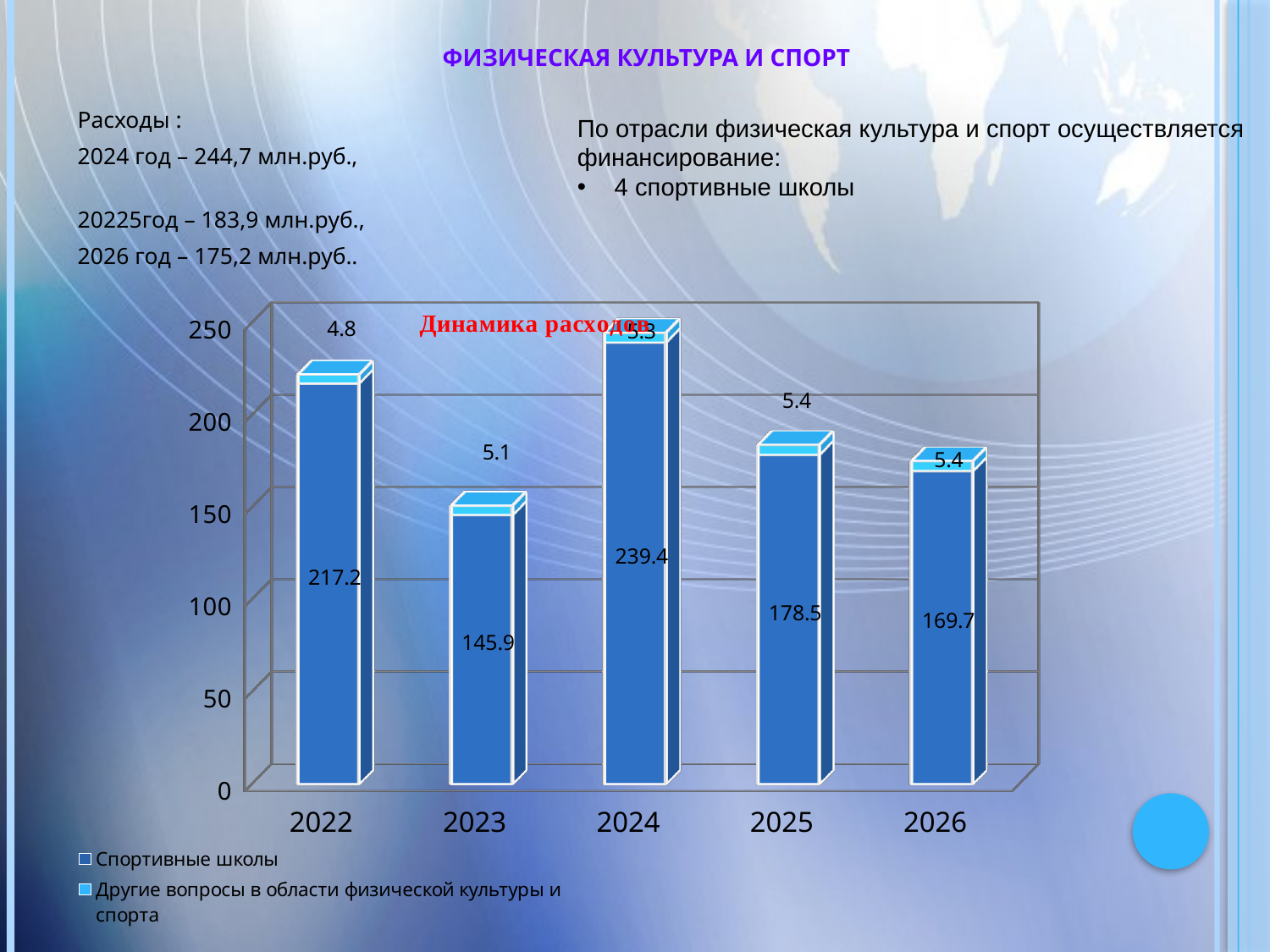
What is the value for Другие вопросы в области физической культуры и спорта in 2022? 4.8 What is the value for Спортивные школы in 2024? 239.4 In which year is the value for Спортивные школы the highest? 2024 What kind of chart is shown on the slide? bar chart What is the difference between the Спортивные школы values for 2025 and 2023? 32.6 In which year is the value for Спортивные школы the lowest? 2023 Which year has the larger value for Спортивные школы, 2025 or 2026? 2025 How many series does the legend list? 2 What is the difference between the Спортивные школы values for 2024 and 2022? 22.2 What is the total of the stacked bar for 2024? 244.7 How many years are shown on the x axis of the chart? 5 What is the title of the chart? Динамика расходов